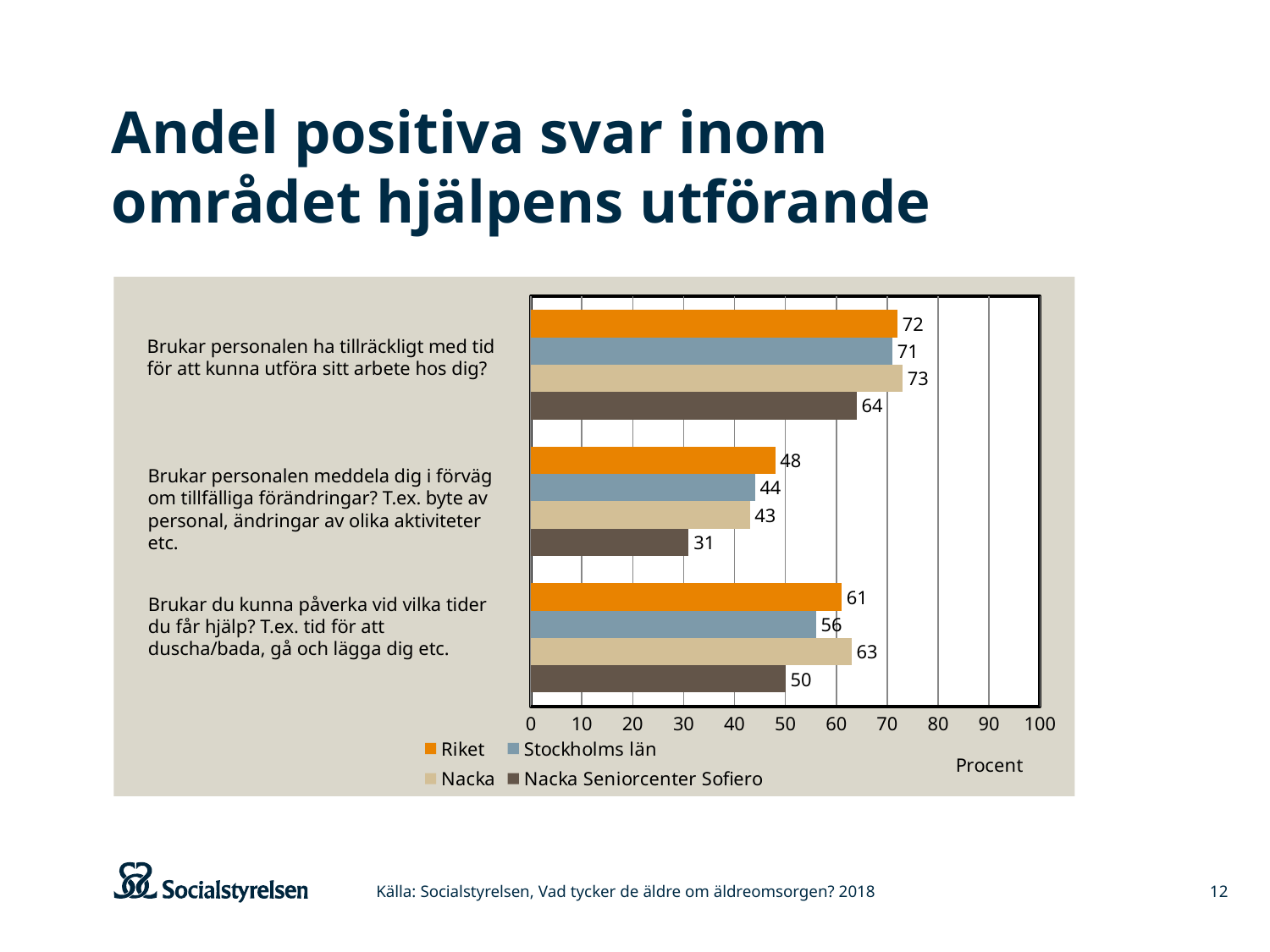
How many questions (categories) are shown on the chart? 3 What kind of chart is shown on the slide? Bar chart What is the value for Nacka Seniorcenter Sofiero on the question "Brukar personalen meddela dig i förväg om tillfälliga förändringar?"? 31 How many series does the legend list? 4 Which series has the lowest value on the question "Brukar du kunna påverka vid vilka tider du får hjälp?"? Nacka Seniorcenter Sofiero What is the value for Nacka on the question "Brukar du kunna påverka vid vilka tider du får hjälp?"? 63 Which is larger on the question "Brukar du kunna påverka vid vilka tider du får hjälp?": Riket or Nacka? Nacka What is the value for Riket on the question "Brukar personalen ha tillräckligt med tid för att kunna utföra sitt arbete hos dig?"? 72 What is the label of the horizontal axis? Procent Which series has the highest value on the question "Brukar personalen ha tillräckligt med tid för att kunna utföra sitt arbete hos dig?"? Nacka What is the difference between Riket and Nacka Seniorcenter Sofiero on the question "Brukar personalen meddela dig i förväg om tillfälliga förändringar?"? 17 What is the value for Stockholms län on the question "Brukar du kunna påverka vid vilka tider du får hjälp?"? 56